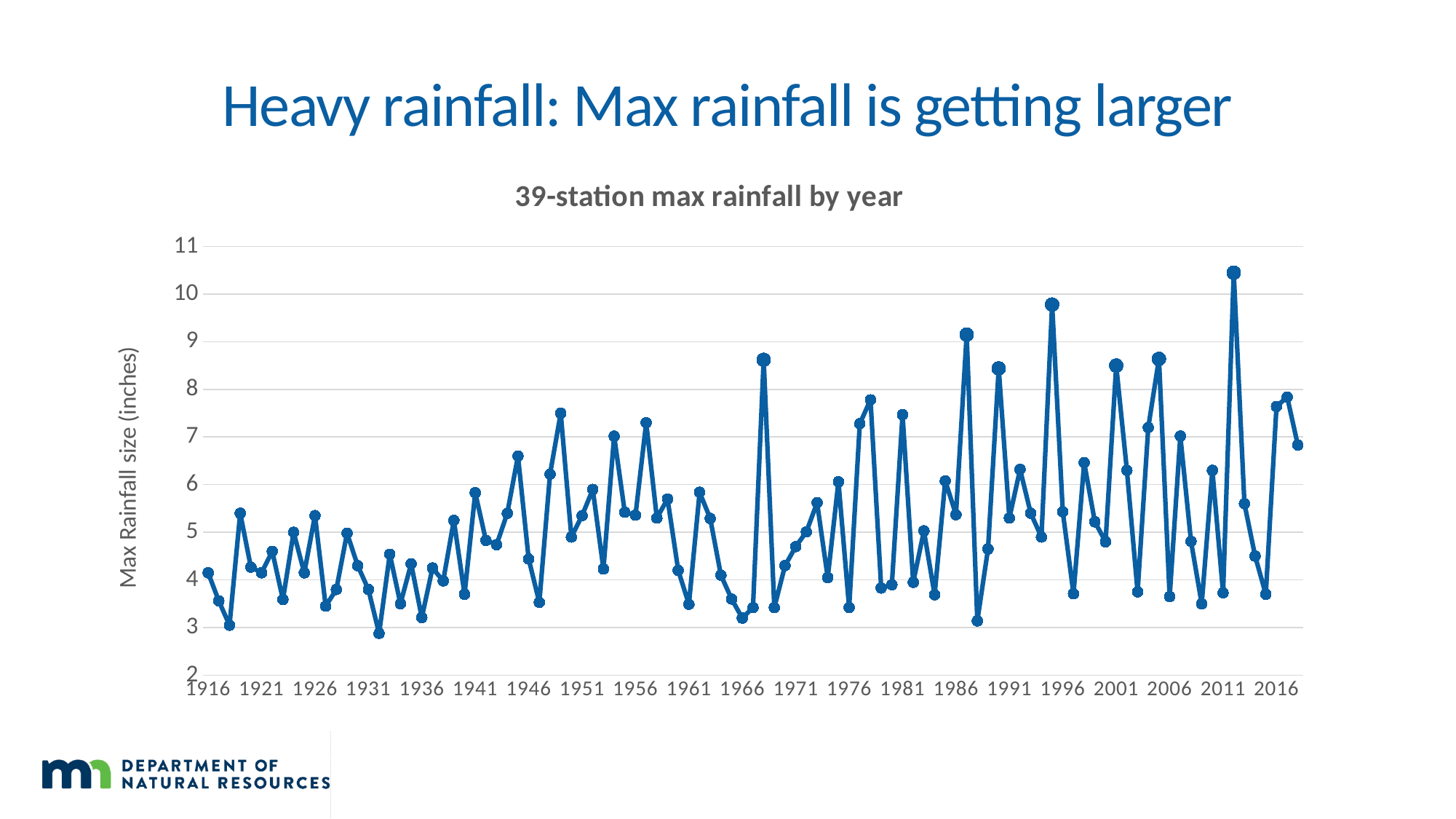
Is the highest value plotted on the chart greater or less than 10? greater Overall, do the max rainfall values tend to rise or fall from 1916 to 2016? rise Is the value for 1936 greater or less than 4? less Is the value for 2016 greater or less than 4? greater What kind of chart is shown on the slide? line chart What is the label on the vertical axis of the chart? Max Rainfall size (inches) What is the title of the chart? 39-station max rainfall by year